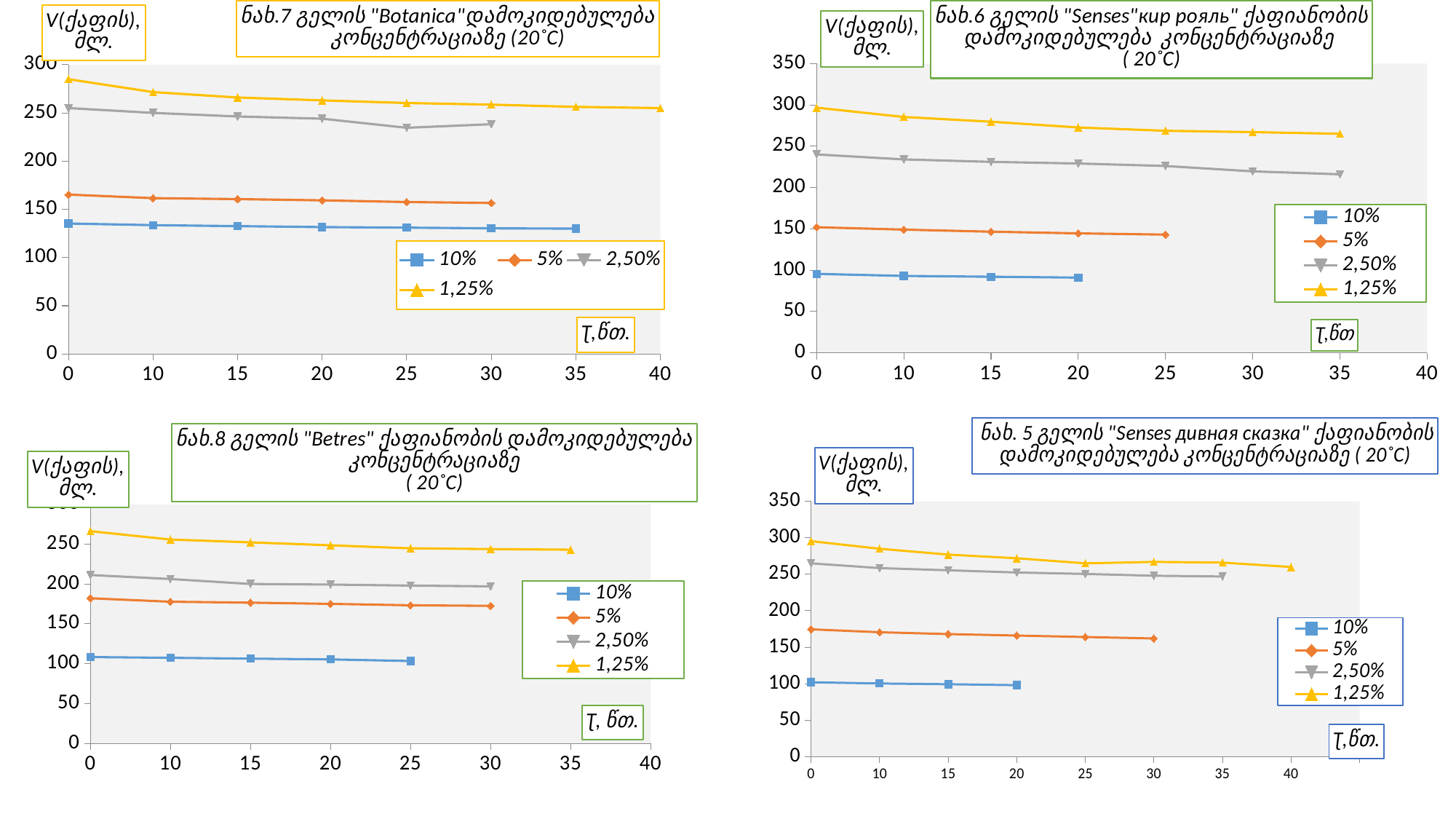
In the bottom-left chart (Betres), is the value of the 2,50% series at t=0 greater or less than 200? greater In the bottom-left chart (Betres), how many data points does the 5% series have? 6 In the top-left chart (Botanica), is the value of the 1,25% series at t=0 greater or less than 250? greater In the top-left chart (Botanica), what kind of chart is shown? line chart In the top-left chart (Botanica), which series has the highest values? 1,25% In the bottom-right chart (Senses дивная сказка), which is larger at t=0: the 5% series or the 2,50% series? 2,50% In the bottom-right chart (Senses дивная сказка), how many data points does the 1,25% series have? 8 In the top-right chart (Senses кир рояль), how many data points does the 10% series have? 4 In the top-right chart (Senses кир рояль), which series has the lowest values? 10% In the top-left chart (Botanica), how many series does the legend list? 4 In the top-left chart (Botanica), do the values of the 5% series rise or fall as t increases? fall